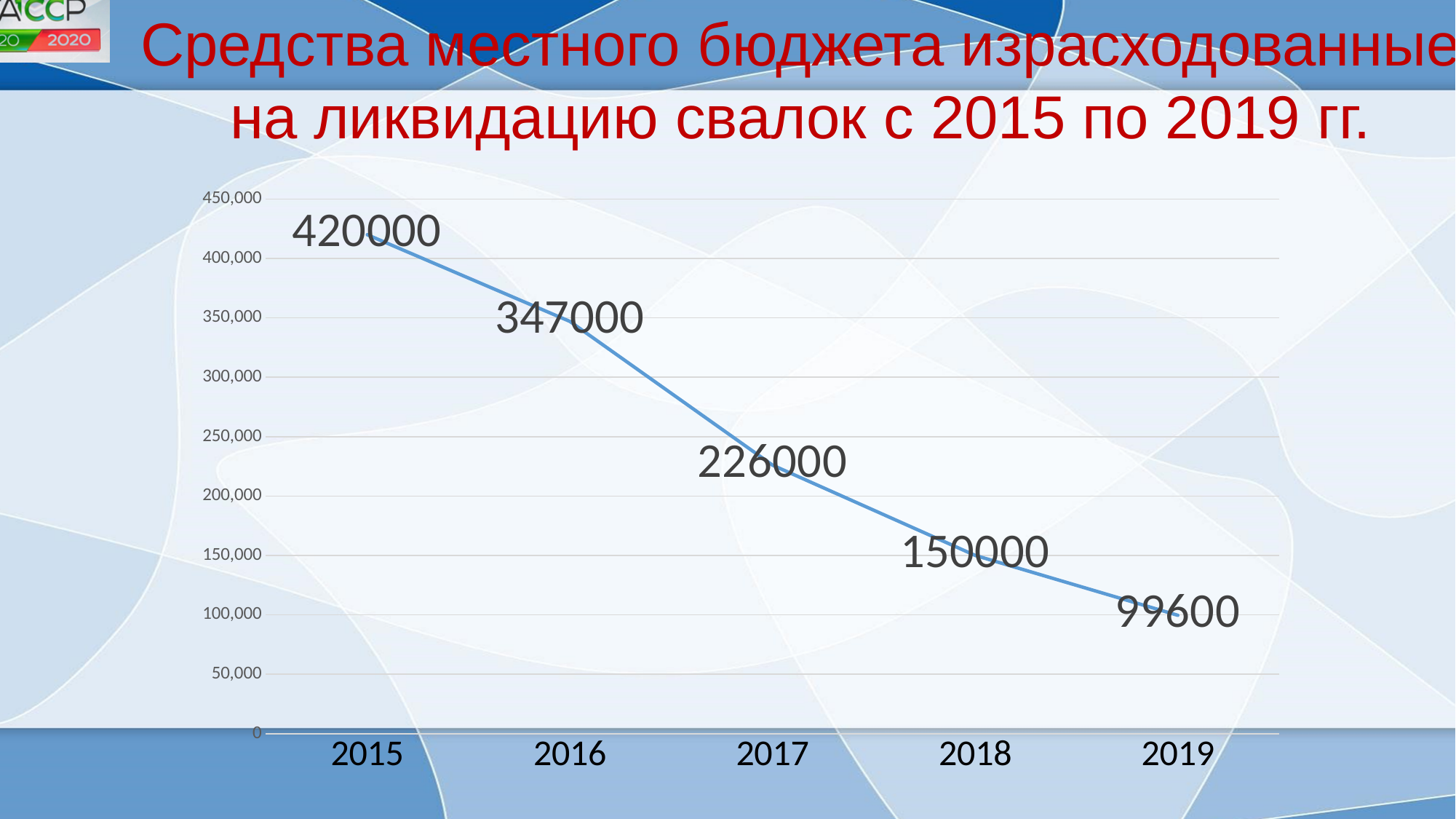
Is the value for 2018 greater or less than 200,000? less Which is larger, the value for 2016 or the value for 2017? 2016 What is the difference between the values for 2015 and 2016? 73000 What value is shown for 2017? 226000 What is the difference between the values for 2018 and 2019? 50400 How many years are plotted on the chart? 5 What kind of chart is shown on the slide? line chart What value is shown for 2019? 99600 Which year has the lowest value? 2019 What value is shown for 2015? 420000 Do the values rise or fall from 2015 to 2019? fall Which year has the highest value? 2015